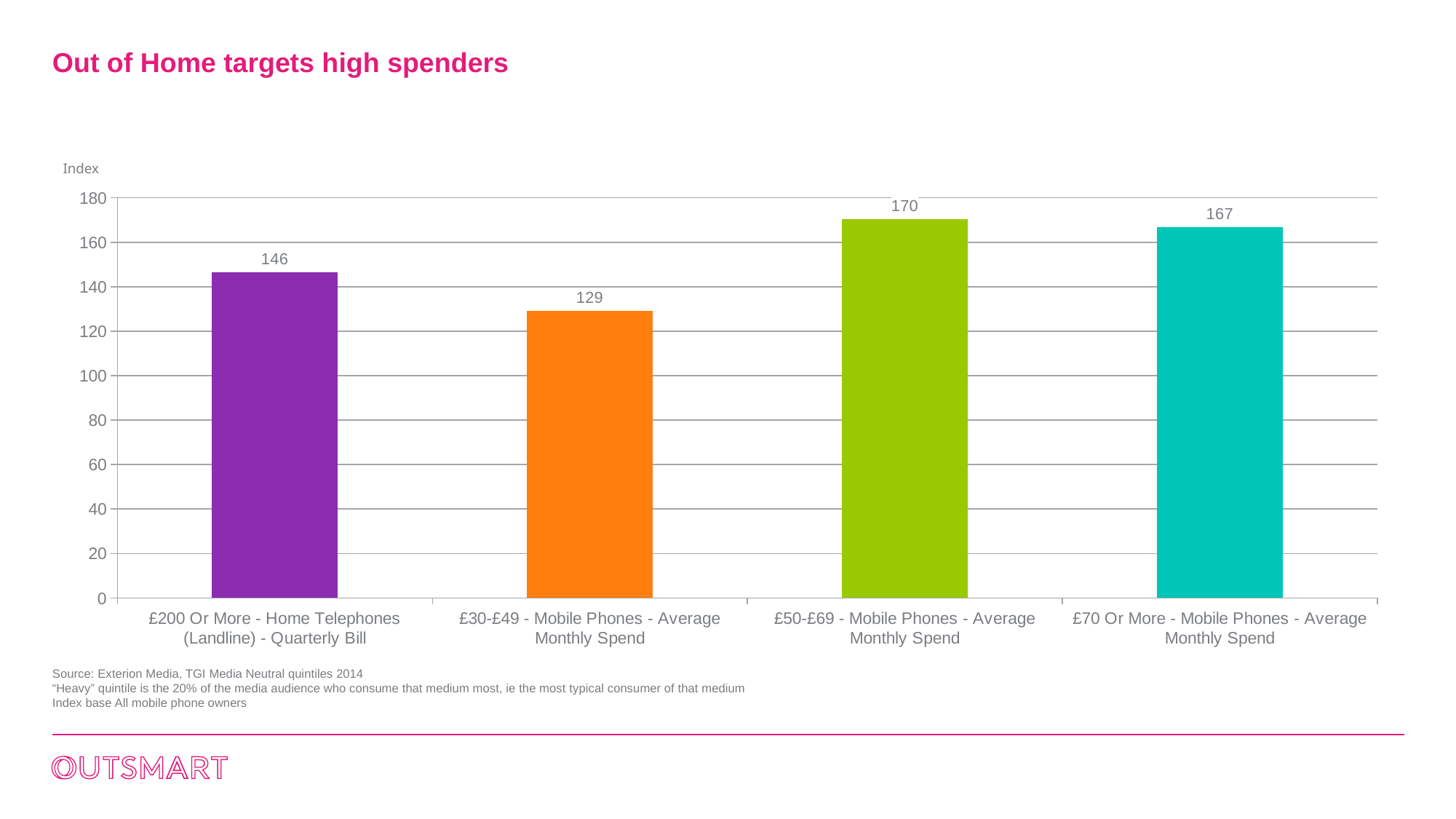
Is the index value for £30-£49 - Mobile Phones - Average Monthly Spend greater or less than 140? less Which category has the lowest index value? £30-£49 - Mobile Phones - Average Monthly Spend What is the index value for £70 Or More - Mobile Phones - Average Monthly Spend? 167 What kind of chart is shown on the slide? Bar chart What is the index value for £30-£49 - Mobile Phones - Average Monthly Spend? 129 What is the difference between the index values for £50-£69 - Mobile Phones - Average Monthly Spend and £30-£49 - Mobile Phones - Average Monthly Spend? 41 What is the title of the slide? Out of Home targets high spenders What is the index value for £200 Or More - Home Telephones (Landline) - Quarterly Bill? 146 Which is larger: the index for £200 Or More - Home Telephones (Landline) - Quarterly Bill or for £70 Or More - Mobile Phones - Average Monthly Spend? £70 Or More - Mobile Phones - Average Monthly Spend What is the index value for £50-£69 - Mobile Phones - Average Monthly Spend? 170 Which category has the highest index value? £50-£69 - Mobile Phones - Average Monthly Spend How many categories are shown in the chart? 4